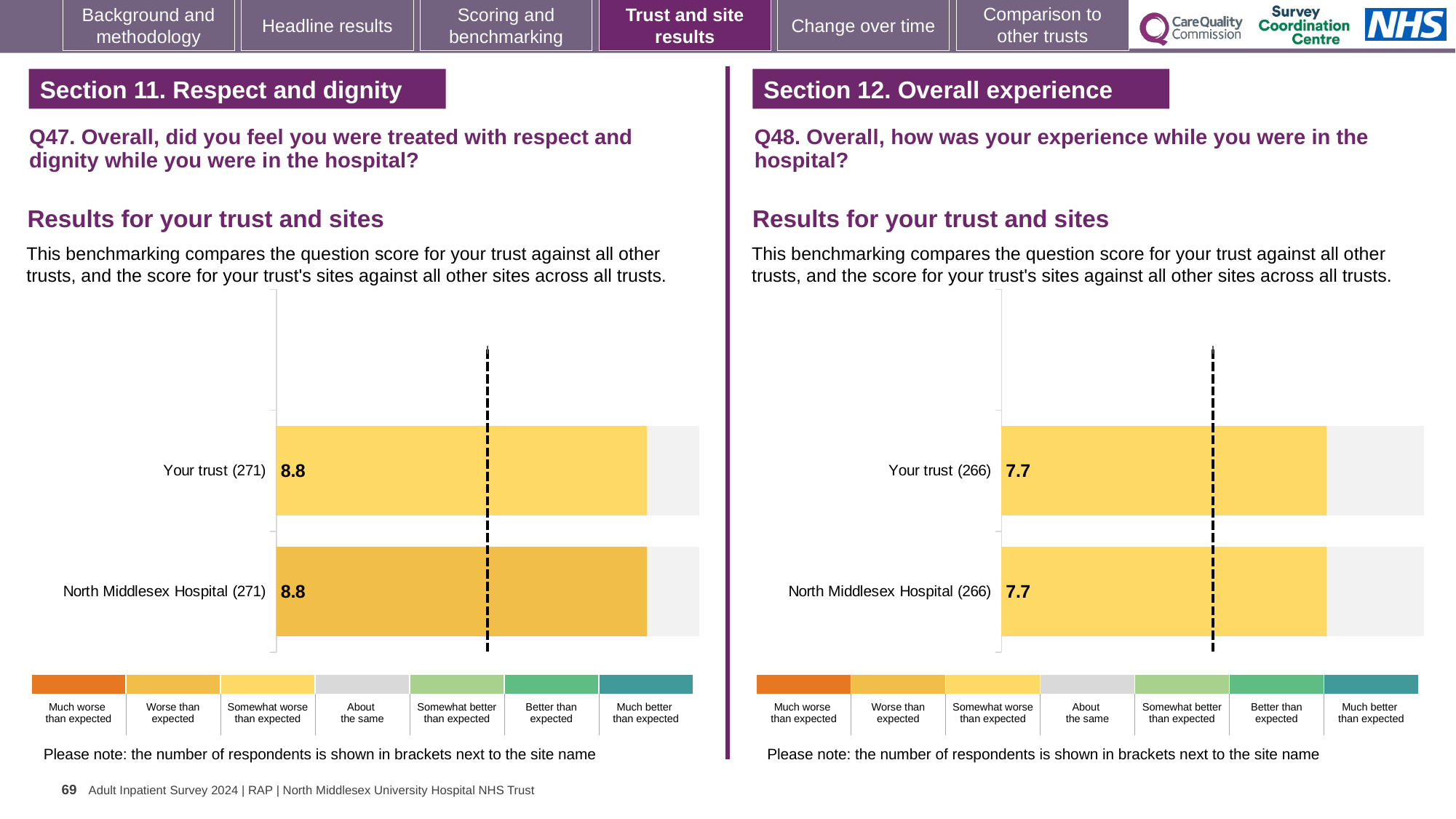
In the Q48 chart on the right, how many respondents are shown in brackets for North Middlesex Hospital? 266 In the Q47 chart on the left, what is the score for North Middlesex Hospital? 8.8 In the Q47 chart on the left, how many respondents are shown in brackets for Your trust? 271 What kind of chart is used in the Q47 chart on the left? Bar chart How many bars are plotted in the Q47 chart on the left? 2 How many categories does the colour key below the Q48 chart on the right list? 7 In the Q47 chart on the left, what is the difference between the score for Your trust and the score for North Middlesex Hospital? 0 In the Q48 chart on the right, what is the difference between the score for Your trust and the score for North Middlesex Hospital? 0 In the Q47 chart on the left, what is the score for Your trust? 8.8 How many bars are plotted in the Q48 chart on the right? 2 In the Q48 chart on the right, what is the score for North Middlesex Hospital? 7.7 In the Q48 chart on the right, what is the score for Your trust? 7.7